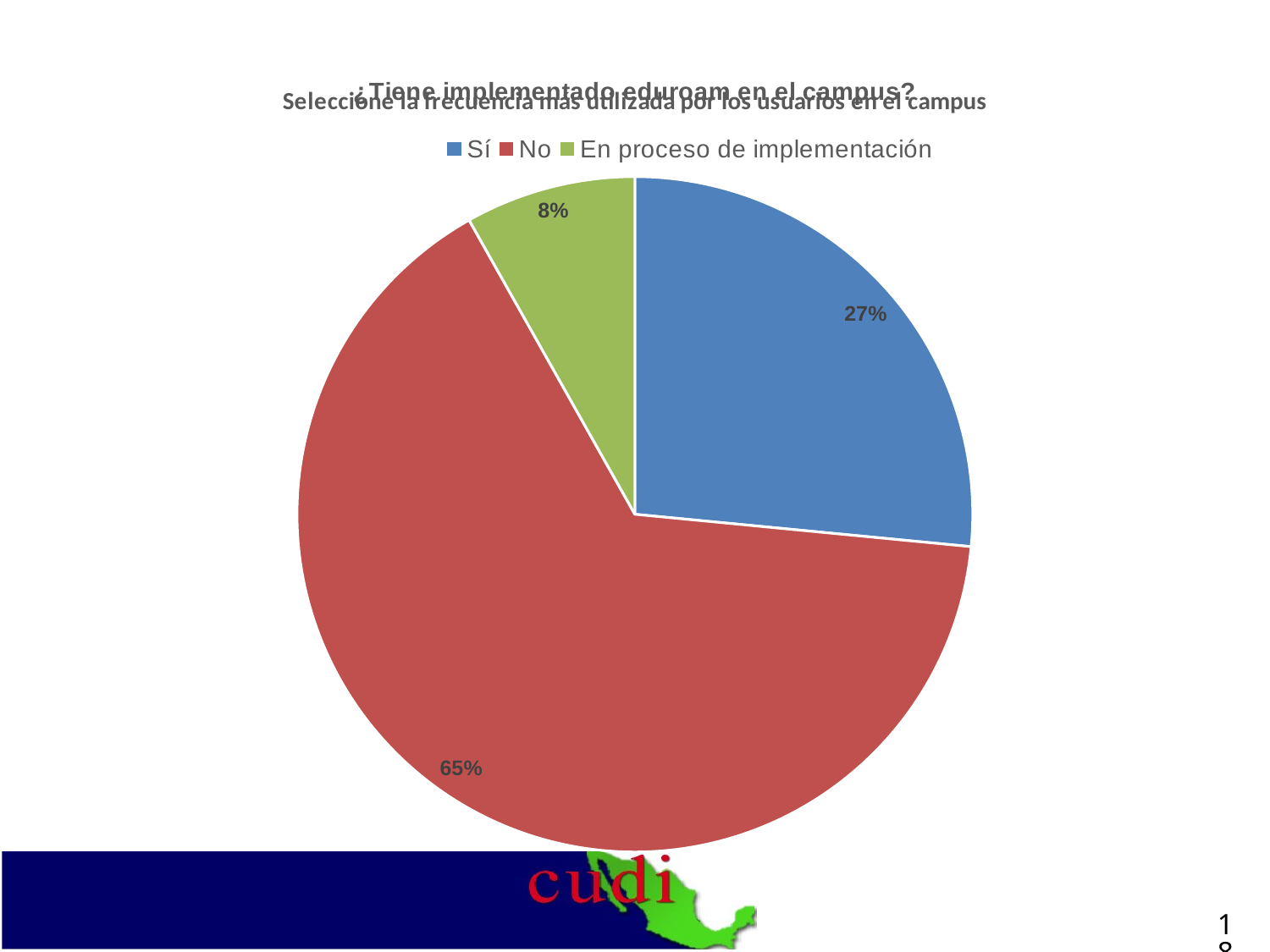
Which slice is larger, "Sí" or "En proceso de implementación"? Sí What colour is the "No" slice in the pie chart? Red Which category has the largest slice of the pie? No Which category has the smallest slice of the pie? En proceso de implementación How many entries does the legend list? 3 What percentage of the pie is labelled "No"? 65% What is the difference in percentage points between the "No" slice and the "Sí" slice? 38 How many slices does the pie chart have? 3 What kind of chart is shown on the slide? Pie chart What percentage of the pie is labelled "Sí"? 27% What is the difference in percentage points between the "Sí" slice and the "En proceso de implementación" slice? 19 What percentage of the pie is labelled "En proceso de implementación"? 8%